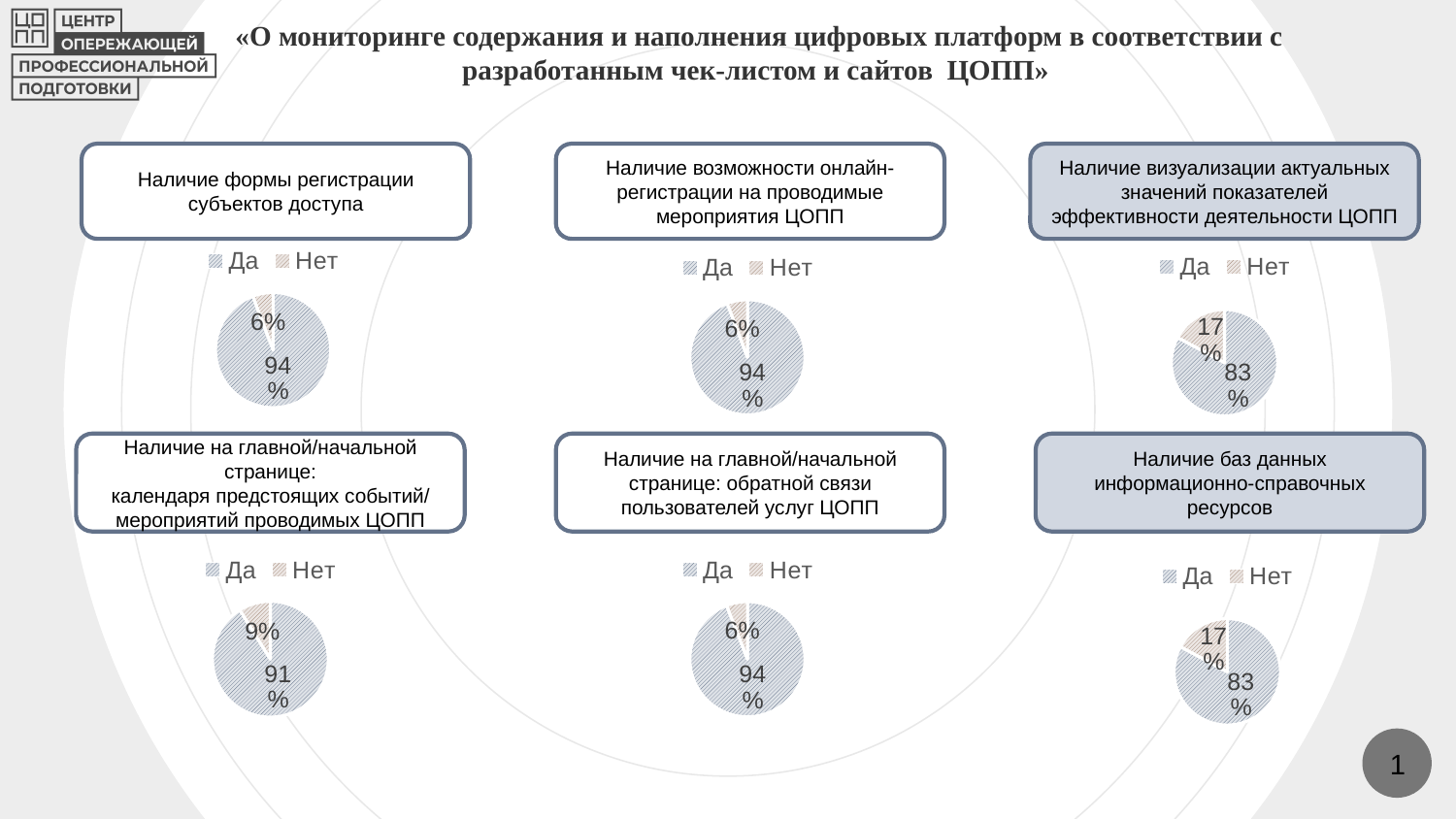
In the top-middle chart 'Наличие возможности онлайн-регистрации на проводимые мероприятия ЦОПП', what share is 'Да'? 94% In the bottom-right chart 'Наличие баз данных информационно-справочных ресурсов', which slice is larger, 'Да' or 'Нет'? Да How many entries does the legend of the top-left chart 'Наличие формы регистрации субъектов доступа' list? 2 What type of chart is used for 'Наличие формы регистрации субъектов доступа'? Pie chart In the bottom-left chart 'Наличие на главной/начальной странице: календаря предстоящих событий/мероприятий проводимых ЦОПП', what is the difference between 'Да' and 'Нет'? 82% In the top-right chart 'Наличие визуализации актуальных значений показателей эффективности деятельности ЦОПП', what share is 'Да'? 83% In the bottom-middle chart 'Наличие на главной/начальной странице: обратной связи пользователей услуг ЦОПП', what share is 'Да'? 94% In the top-left chart 'Наличие формы регистрации субъектов доступа', what share is 'Нет'? 6% In the top-left chart 'Наличие формы регистрации субъектов доступа', what share is 'Да'? 94% In the top-right chart 'Наличие визуализации актуальных значений показателей эффективности деятельности ЦОПП', what share is 'Нет'? 17% In the bottom-right chart 'Наличие баз данных информационно-справочных ресурсов', what is the difference between 'Да' and 'Нет'? 66% In the bottom-left chart 'Наличие на главной/начальной странице: календаря предстоящих событий/мероприятий проводимых ЦОПП', what share is 'Нет'? 9%